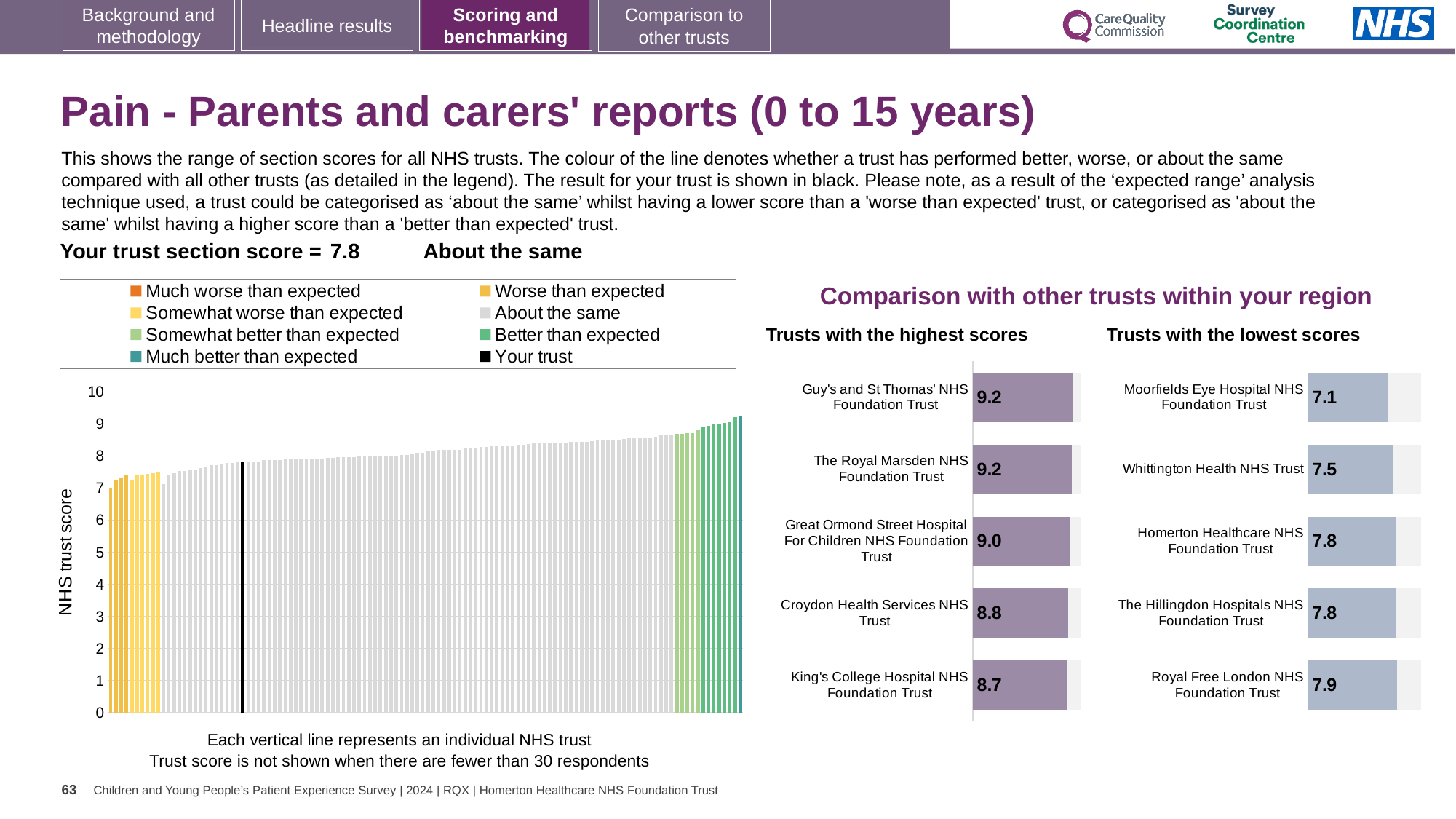
In the main chart on the left, do the trust scores rise or fall from left to right? Rise In the 'Trusts with the lowest scores' chart, how much higher is Royal Free London NHS Foundation Trust's score than Moorfields Eye Hospital NHS Foundation Trust's score? 0.8 What kind of chart is the main chart on the left showing NHS trust scores? Bar chart In the 'Trusts with the lowest scores' chart, what is the score for Moorfields Eye Hospital NHS Foundation Trust? 7.1 In the 'Trusts with the highest scores' chart, which trust has the lowest score? King's College Hospital NHS Foundation Trust How many trusts are listed in the 'Trusts with the highest scores' chart? 5 In the 'Trusts with the highest scores' chart, which has the larger score: Croydon Health Services NHS Trust or King's College Hospital NHS Foundation Trust? Croydon Health Services NHS Trust How many entries does the legend of the main NHS trust score chart on the left list? 8 In the 'Trusts with the highest scores' chart, what is the score for Great Ormond Street Hospital For Children NHS Foundation Trust? 9.0 In the 'Trusts with the lowest scores' chart, which trust has the highest score? Royal Free London NHS Foundation Trust In the main chart on the left, is the value of the tallest bar greater or less than 9? greater In the 'Trusts with the highest scores' chart, what is the difference between the scores of Guy's and St Thomas' NHS Foundation Trust and King's College Hospital NHS Foundation Trust? 0.5